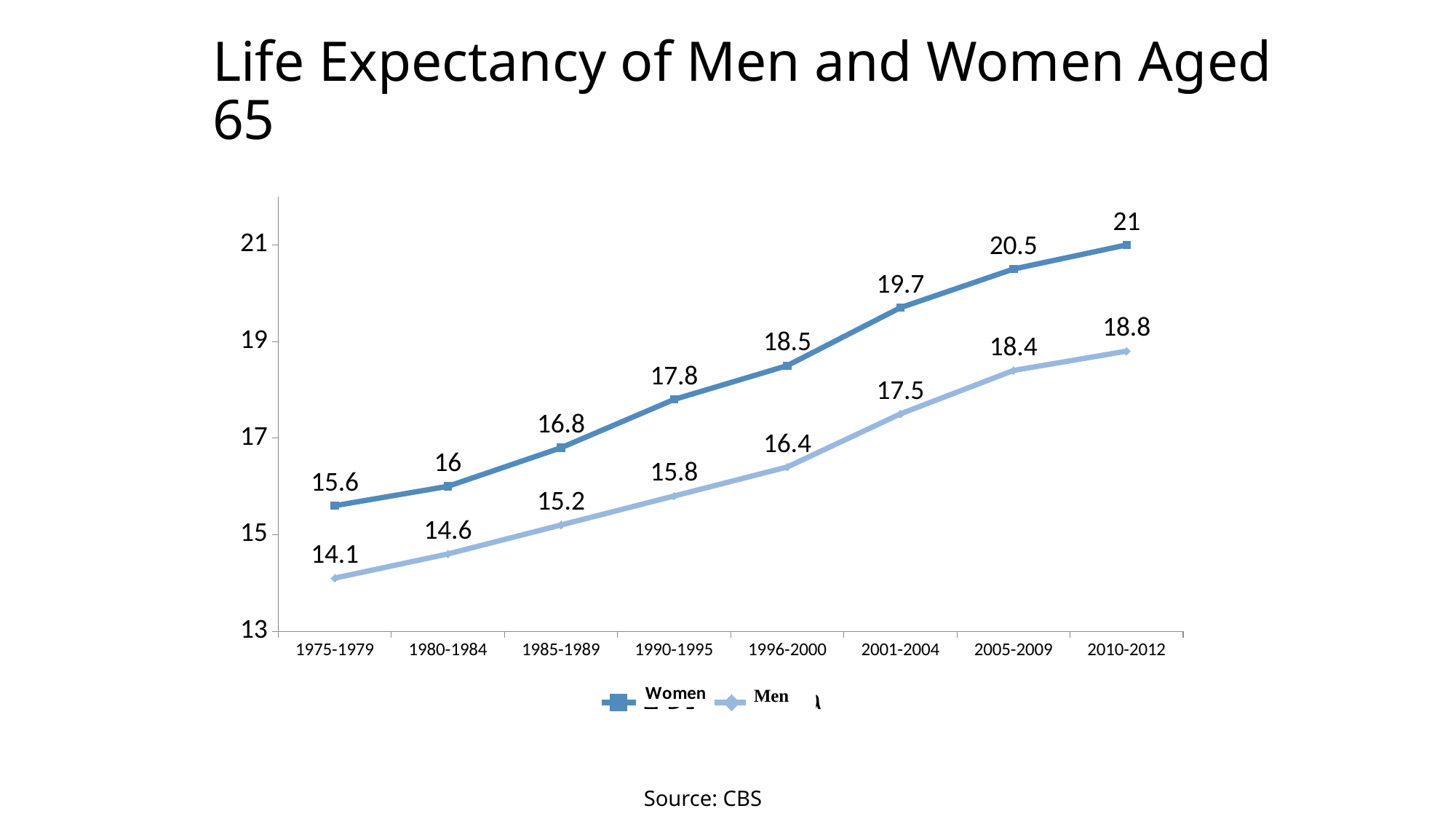
How many periods are shown on the x axis? 8 What kind of chart is shown on the slide? Line chart What is the life expectancy value for Men in 2010-2012? 18.8 What is the difference between the Women and Men values in 2005-2009? 2.1 What is the life expectancy value for Women in 1996-2000? 18.5 Do the values for Men rise or fall from 1975-1979 to 2010-2012? Rise Which is larger: the Men value in 2001-2004 or the Women value in 1990-1995? Women value in 1990-1995 How many series does the legend list? 2 In which period is the value for Women highest? 2010-2012 In which period is the value for Men lowest? 1975-1979 What is the difference between the Women value in 2010-2012 and the Women value in 1975-1979? 5.4 What is the life expectancy value for Men in 1985-1989? 15.2